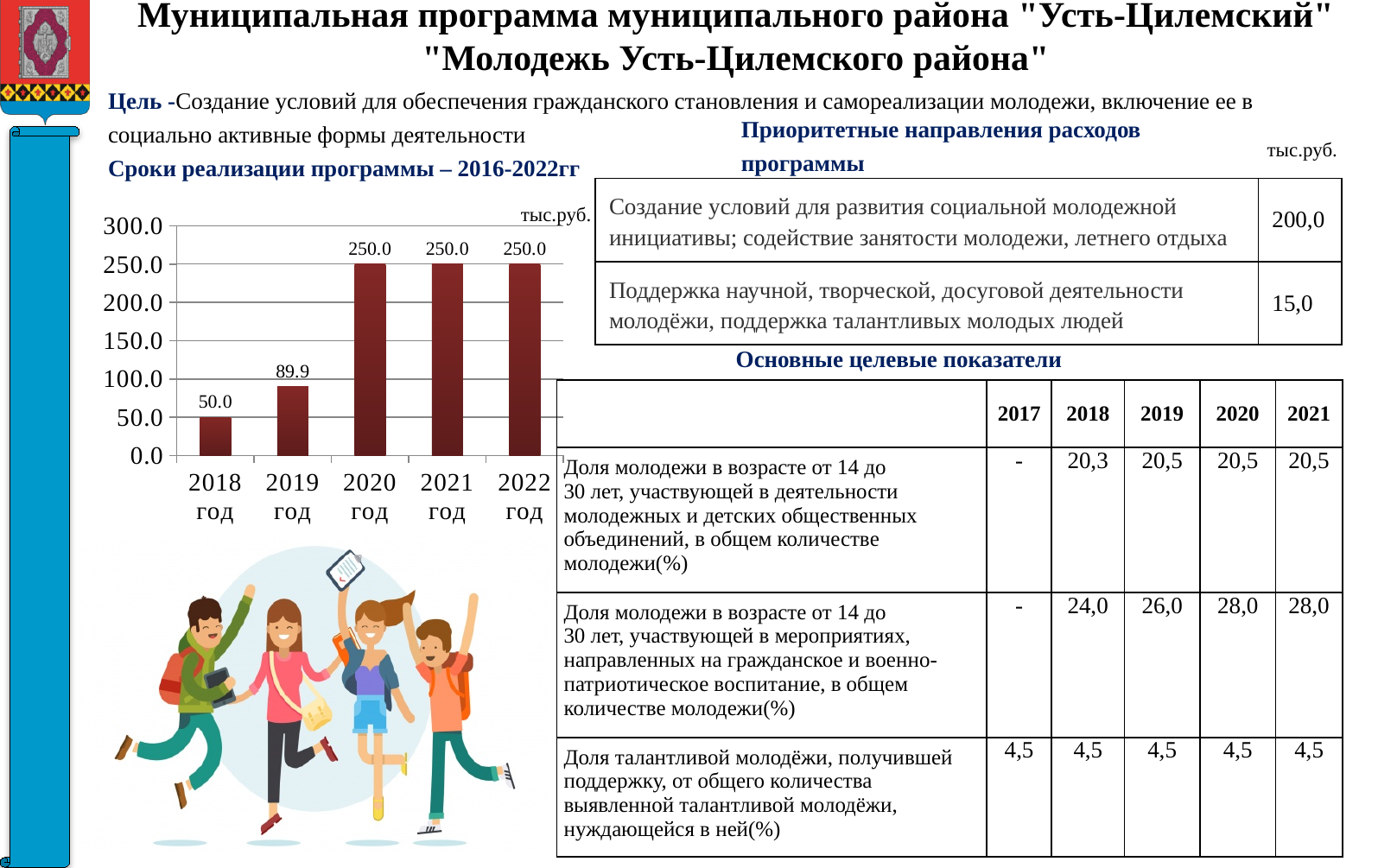
What unit is indicated above the bar chart? тыс.руб. Is the value for 2019 год in the bar chart greater or less than 100.0? less What is the value for 2021 год in the bar chart? 250.0 What type of chart is shown on the slide? bar chart How many years are shown on the x axis of the bar chart? 5 Which is larger in the bar chart, the value for 2019 год or the value for 2022 год? 2022 год Do the values in the bar chart rise or fall from 2018 год to 2020 год? rise What is the value for 2018 год in the bar chart? 50.0 What is the difference between the values for 2020 год and 2019 год in the bar chart? 160.1 What is the difference between the values for 2019 год and 2018 год in the bar chart? 39.9 What is the value for 2019 год in the bar chart? 89.9 Which year has the lowest value in the bar chart? 2018 год